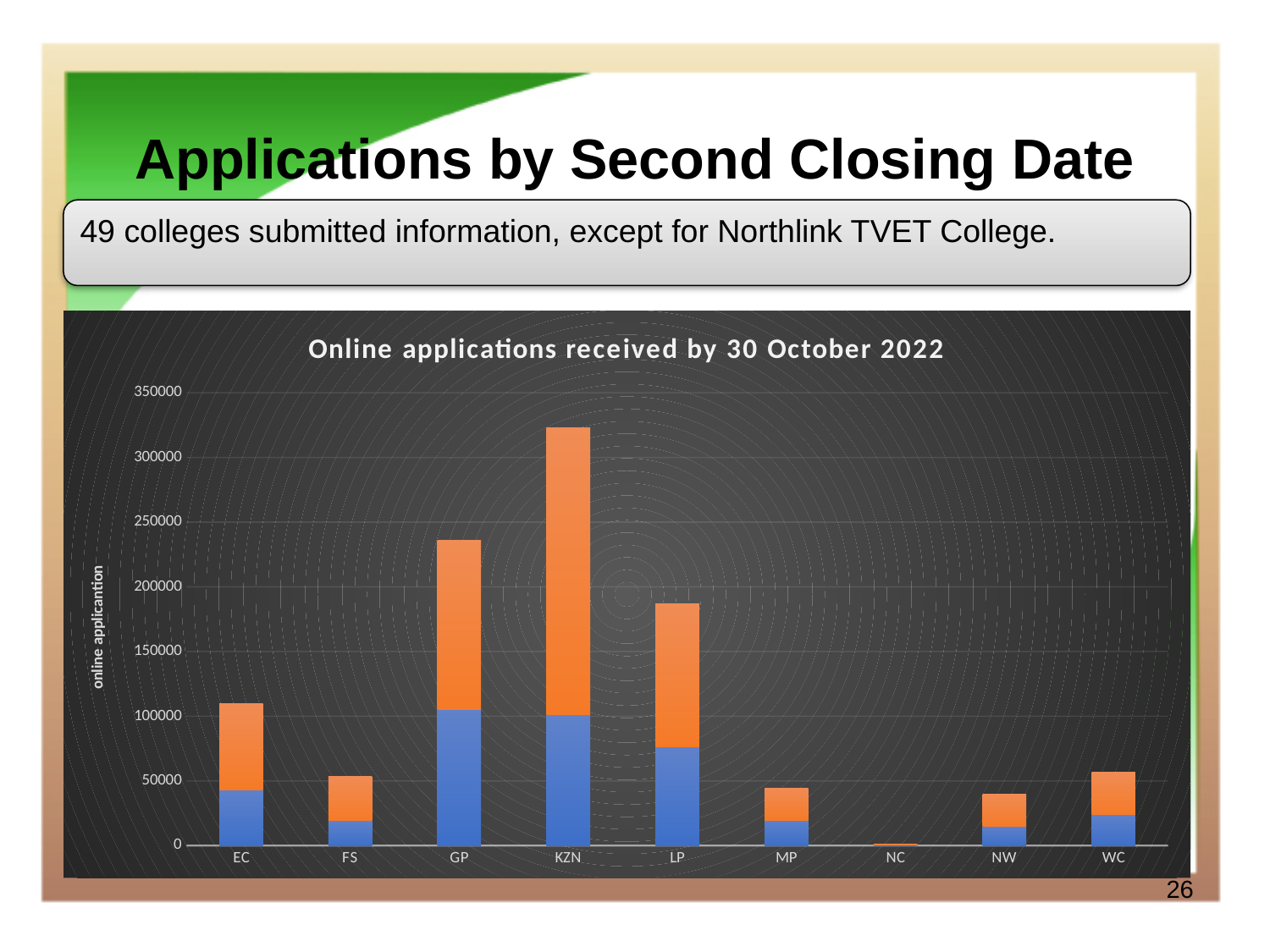
Which province has the highest total of online applications in the chart? KZN How many provinces (categories) are shown on the x axis of the chart? 9 What is the title of the chart? Online applications received by 30 October 2022 Which has a larger total of online applications, WC or NW? WC Is the total value for KZN greater or less than 300000? greater Is the total value for LP greater or less than 200000? less Is the total value for EC greater or less than 100000? greater Which has a larger total of online applications, GP or LP? GP What kind of chart is shown on the slide? stacked bar chart Which province has the lowest total of online applications in the chart? NC